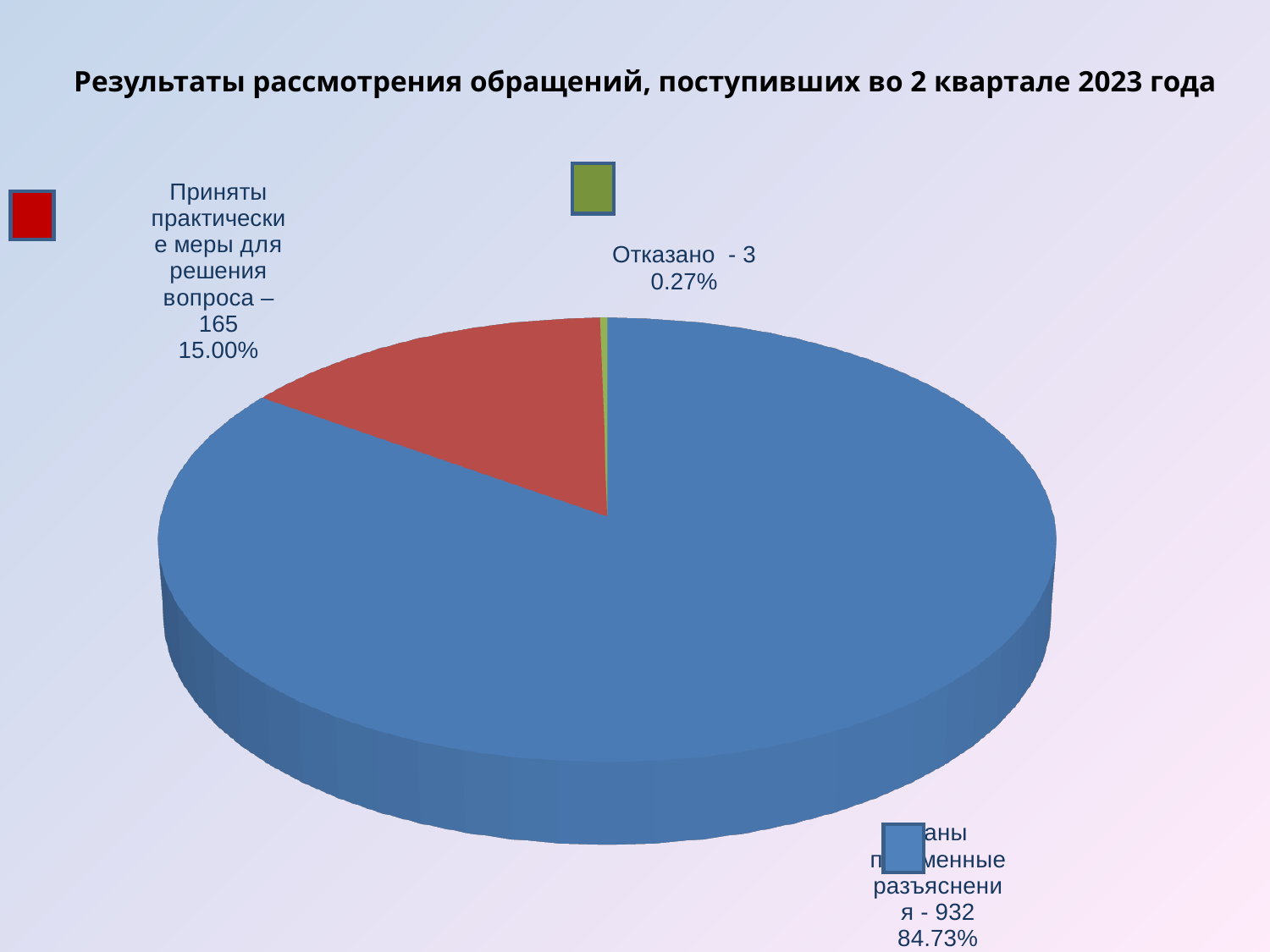
What share of the pie does "Приняты практические меры для решения вопроса" represent? 15.00% What percentage is printed for the largest (blue) slice? 84.73% Which slice of the pie is the smallest? Отказано What is the difference between the value for "Приняты практические меры для решения вопроса" and the value for "Отказано"? 162 What share of the pie does the "Отказано" slice represent? 0.27% How many slices does the pie chart have? 3 What value is printed for the largest slice of the pie? 932 What kind of chart is shown on the slide? pie chart What is the value shown for "Приняты практические меры для решения вопроса"? 165 Which is larger: the value for "Отказано" or the value for "Приняты практические меры для решения вопроса"? Приняты практические меры для решения вопроса What is the title of the chart on the slide? Результаты рассмотрения обращений, поступивших во 2 квартале 2023 года What is the value shown for the slice labelled "Отказано"? 3